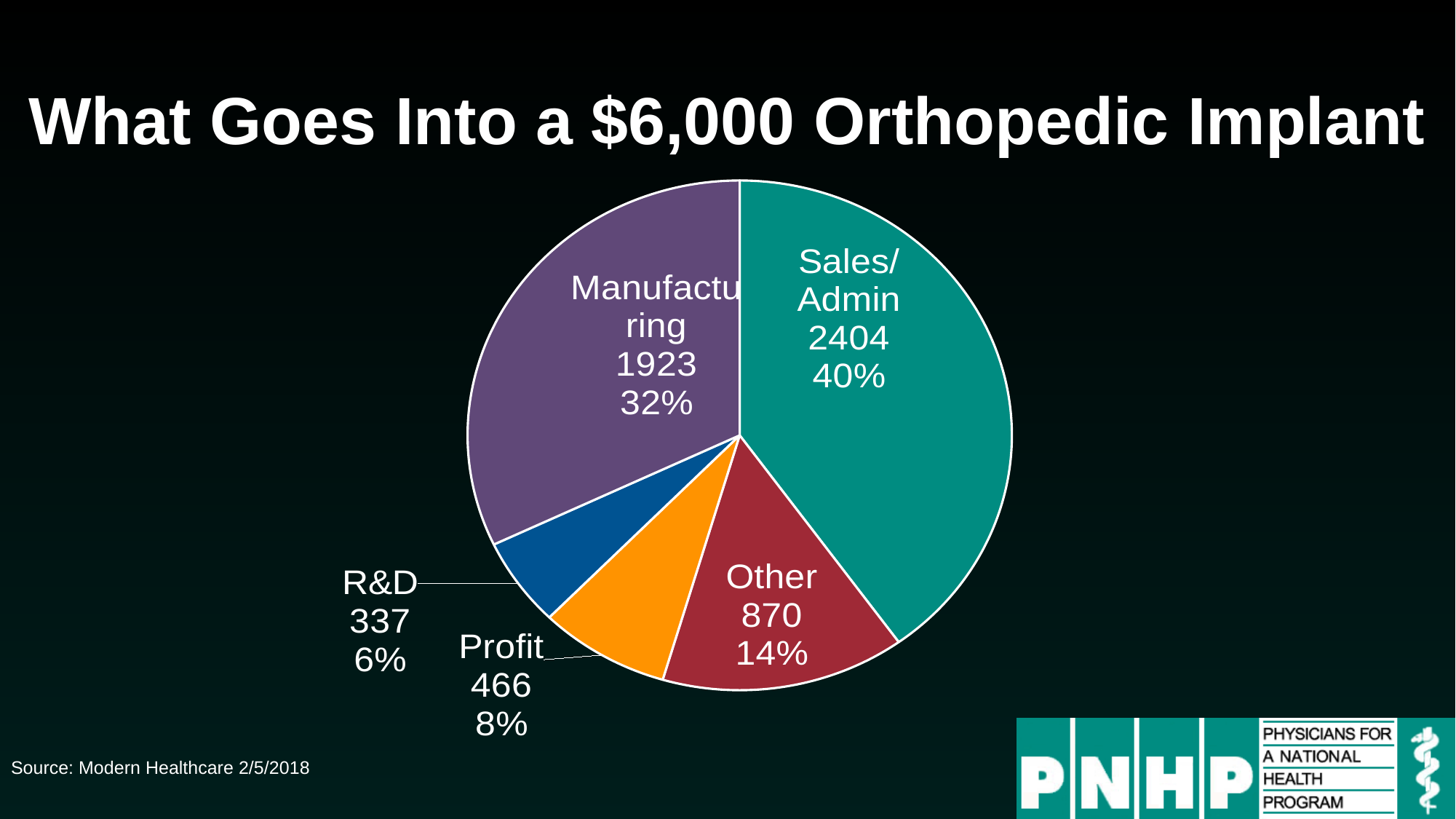
What is the title of the chart? What Goes Into a $6,000 Orthopedic Implant Which category has the largest slice? Sales/Admin Which is larger, the value for Other or the value for Profit? Other What percentage share does Manufacturing have? 32% What is the value for R&D? 337 What is the value for Sales/Admin? 2404 Which category has the smallest slice? R&D What colour is the Profit slice? orange What percentage share does Profit have? 8% How many categories are shown in the pie chart? 5 What type of chart is shown on the slide? pie chart What is the difference between the Sales/Admin value and the Manufacturing value? 481